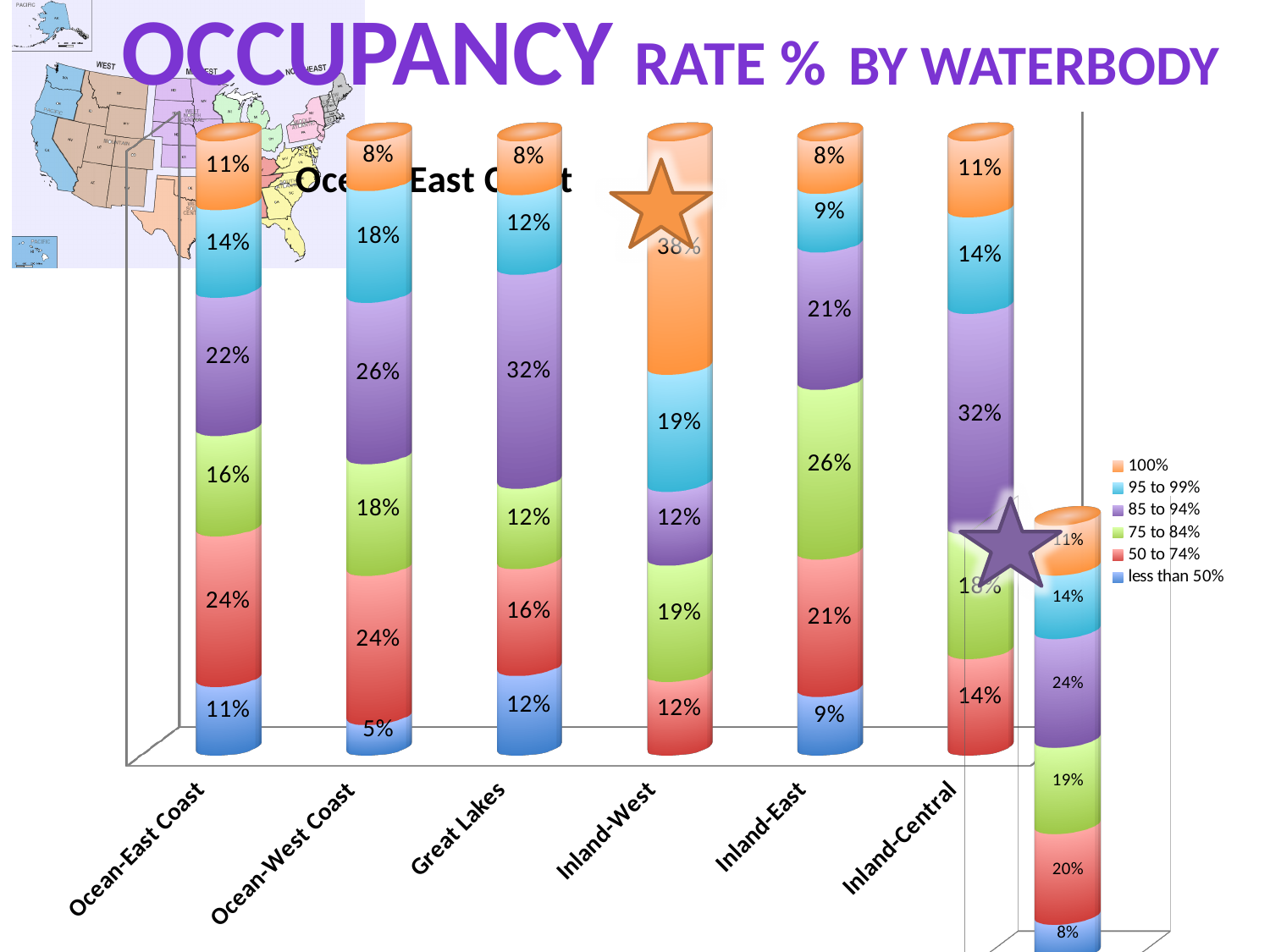
What is the value of the 75 to 84% segment for Inland-East? 26% What is the value of the 50 to 74% segment for Ocean-East Coast? 24% What is the value of the 85 to 94% segment for Great Lakes? 32% Which is larger: the 85 to 94% segment for Ocean-West Coast or for Inland-East? Ocean-West Coast What type of chart is shown on the slide? stacked bar chart What is the difference between the 50 to 74% segment for Ocean-West Coast and for Great Lakes? 8% Which waterbody has the lowest value for the less than 50% segment among those with a labelled blue segment? Ocean-West Coast What is the value of the 95 to 99% segment for Inland-West? 19% How many series does the legend list? 6 What is the value of the less than 50% segment for Ocean-West Coast? 5% How many waterbody categories are labelled on the x axis? 6 Which waterbody has the highest value for the 100% segment? Inland-West